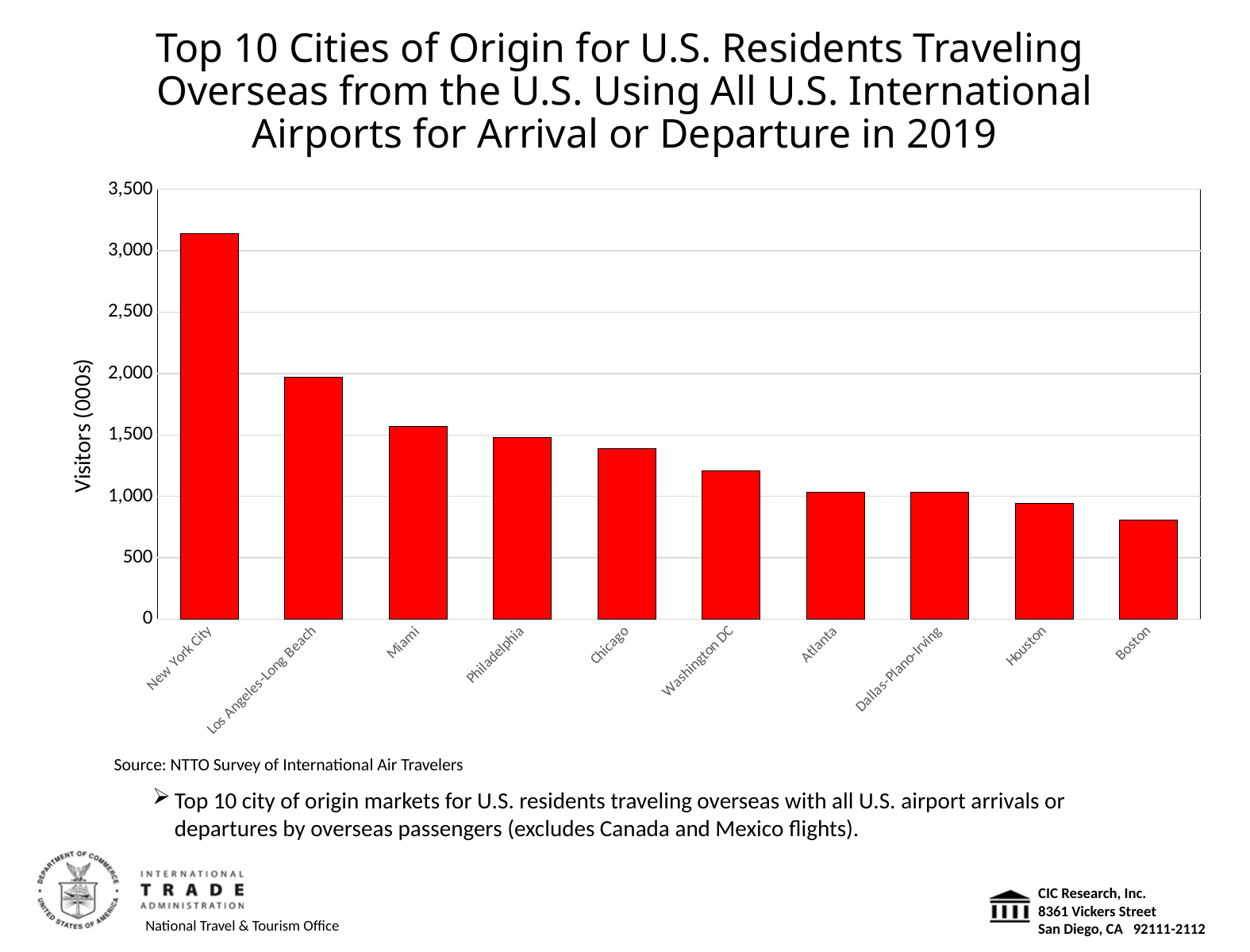
What kind of chart is shown on the slide? bar chart What is the label on the vertical axis? Visitors (000s) Is the value for Houston greater or less than 1,000? less Is the value for Miami greater or less than 2,000? less Which has more visitors, Chicago or Boston? Chicago Which city has the lowest number of visitors? Boston Is the value for Los Angeles-Long Beach greater or less than 1,500? greater Which city has the highest number of visitors? New York City How many cities are shown on the chart? 10 Do the values rise or fall moving from left to right along the x axis? fall